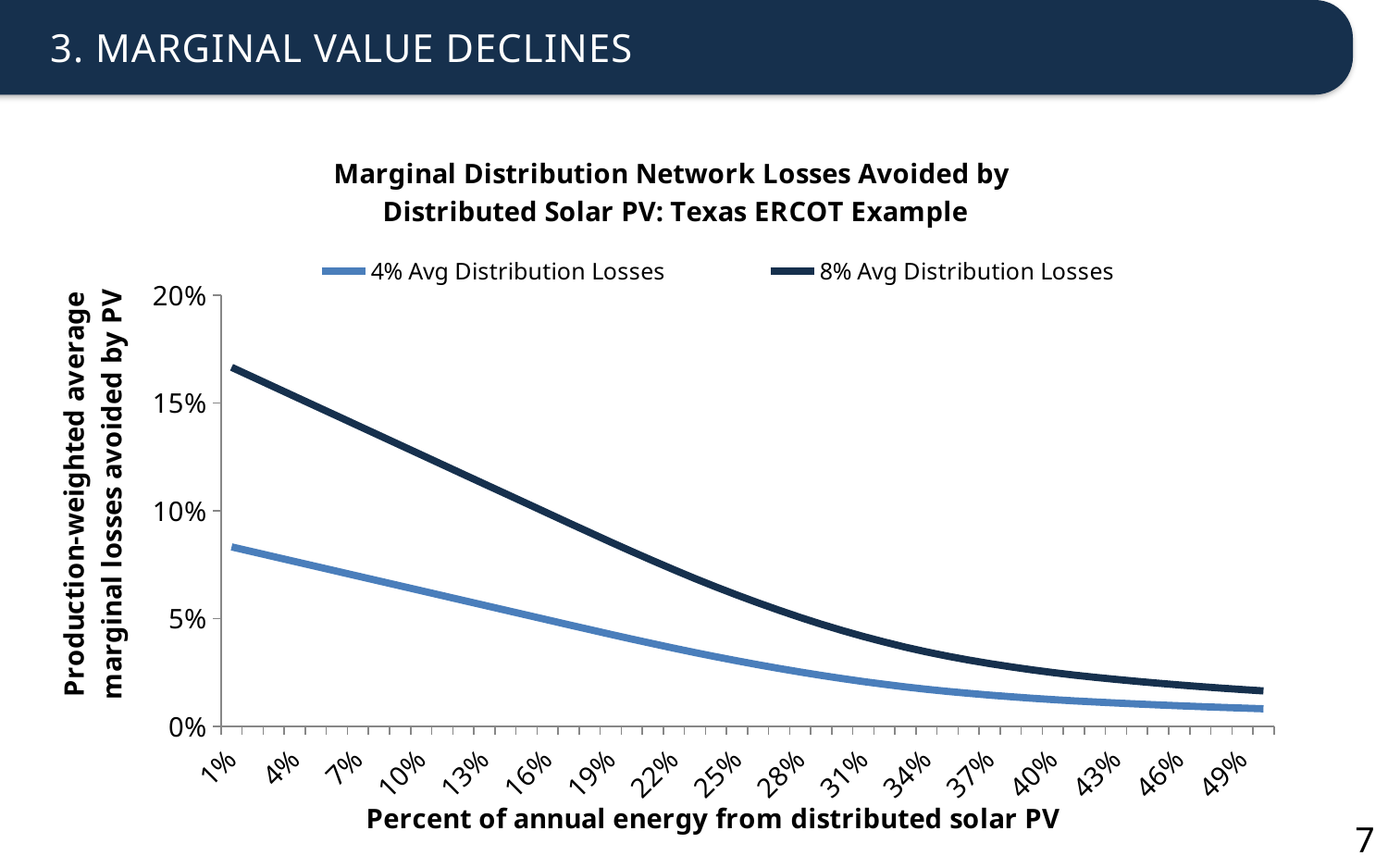
What is the title of the chart? Marginal Distribution Network Losses Avoided by Distributed Solar PV: Texas ERCOT Example Is the value for the 8% Avg Distribution Losses series at 13% greater or less than 10%? greater Is the value for the 8% Avg Distribution Losses series at 49% greater or less than 5%? less Is the value for the 4% Avg Distribution Losses series at 1% greater or less than 10%? less Do the values for the 4% Avg Distribution Losses series rise or fall along the x axis? fall How many labels are shown on the x axis? 17 At 1% of annual energy from distributed solar PV, which series has the higher value: 4% Avg Distribution Losses or 8% Avg Distribution Losses? 8% Avg Distribution Losses How many series does the legend list? 2 Do the values for the 8% Avg Distribution Losses series rise or fall as the percent of annual energy from distributed solar PV increases? fall What kind of chart is shown on the slide? line chart